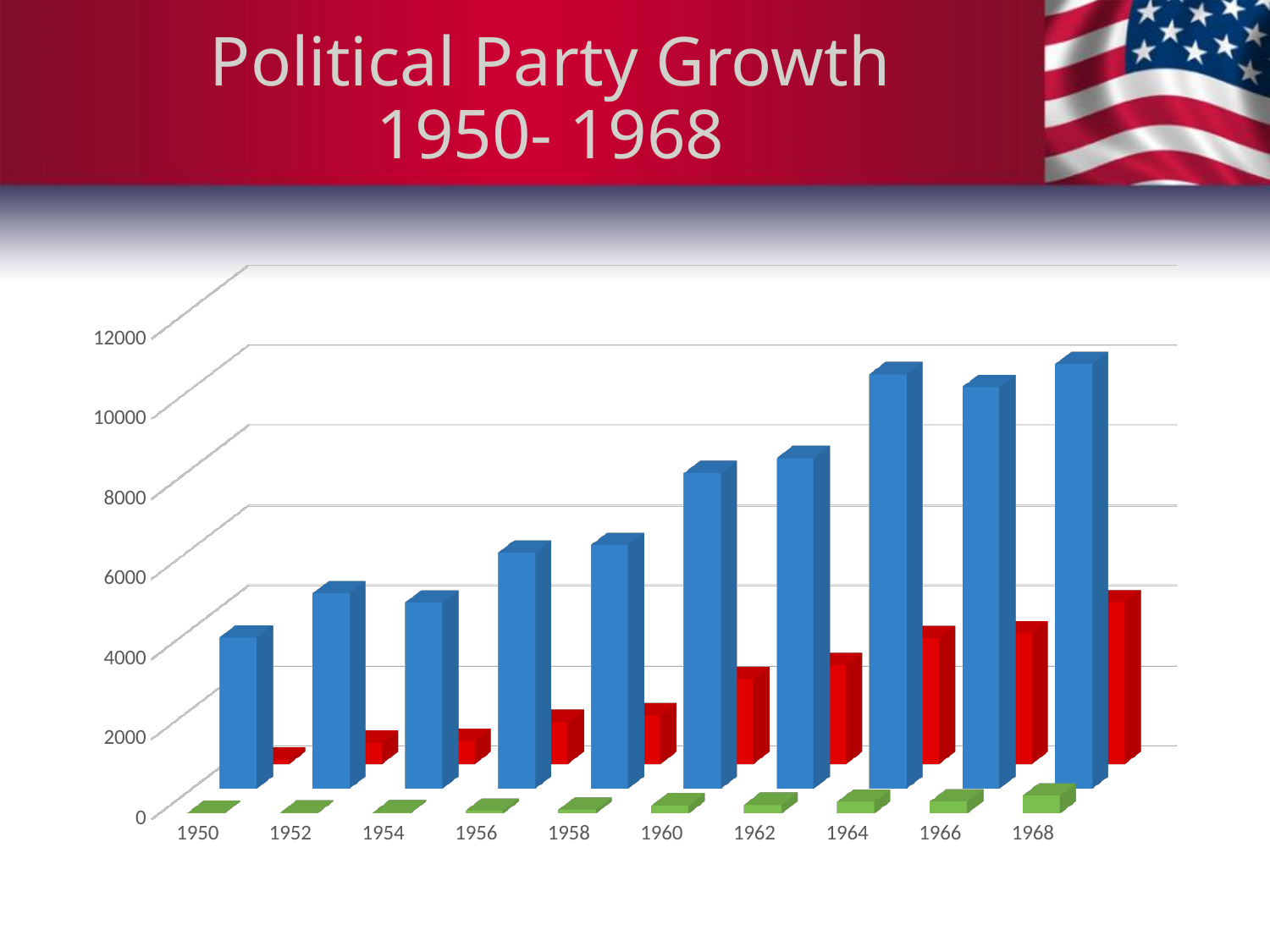
In which year is the blue bar the lowest? 1950 What is the title of the slide's chart? Political Party Growth 1950- 1968 Is the value of the blue bar for 1968 greater or less than 10000? greater Is the value of the blue bar for 1950 greater or less than 6000? less How many years are shown along the x axis of the chart? 10 How many differently coloured bar series are plotted in the chart? 3 Do the red bars generally rise or fall from 1950 to 1968? rise Is the value of the red bar for 1950 greater or less than 2000? less What kind of chart is shown on the slide? bar chart Which is larger, the blue bar for 1956 or the blue bar for 1960? 1960 In which year is the red bar the highest? 1968